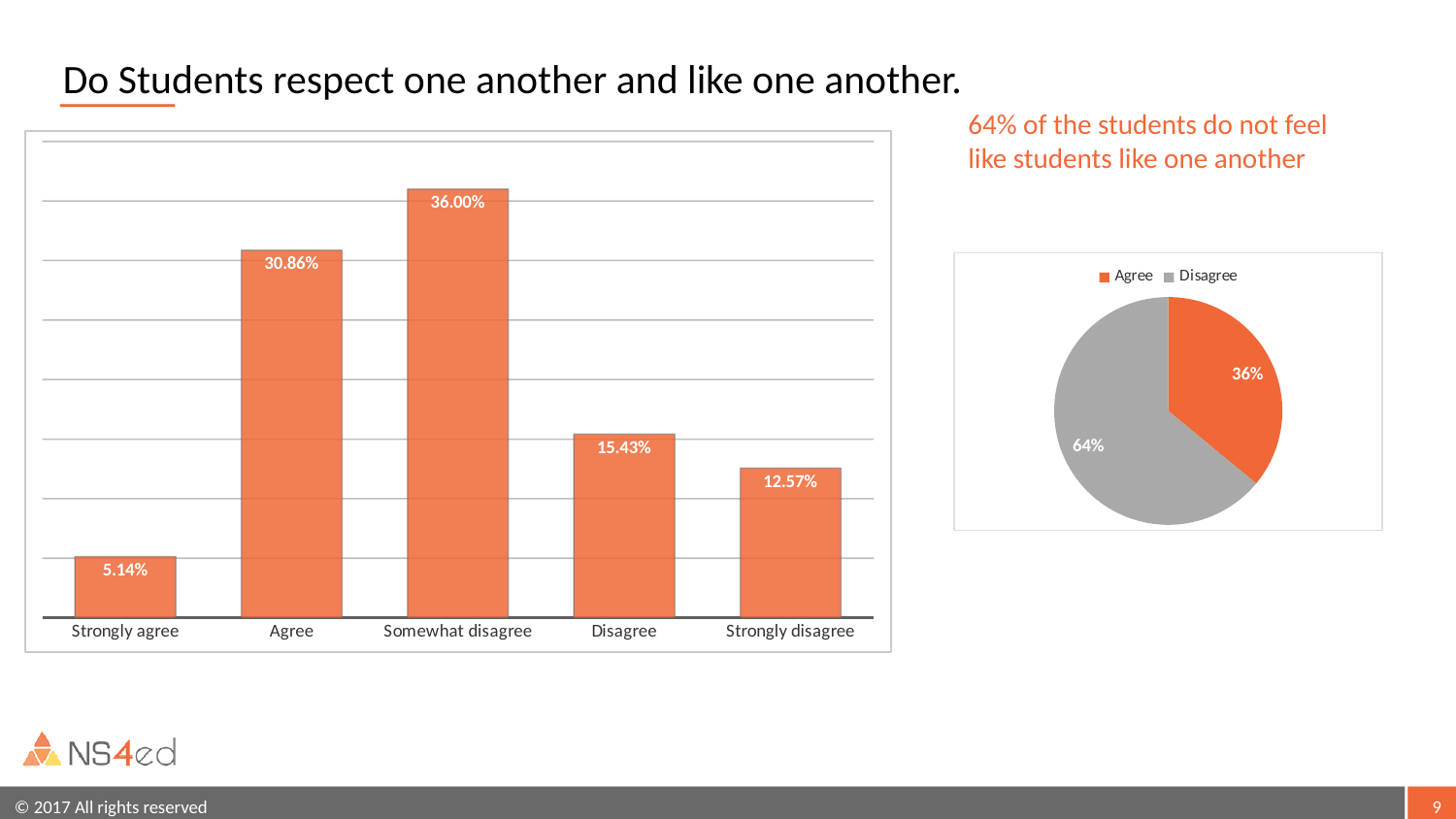
What kind of chart is the chart on the left of the slide? Bar chart In the bar chart on the left, what is the difference between the values for Somewhat disagree and Agree? 5.14% In the bar chart on the left, which is larger, the value for Disagree or the value for Strongly disagree? Disagree In the bar chart on the left, what is the value for Strongly disagree? 12.57% How many categories are shown in the bar chart on the left? 5 In the pie chart on the right, what is the value for Agree? 36% In the pie chart on the right, what share does the Disagree slice have? 64% In the bar chart on the left, what is the value for Agree? 30.86% In the pie chart on the right, what colour is the Agree slice? Orange In the bar chart on the left, which category has the lowest value? Strongly agree In the bar chart on the left, which category has the highest value? Somewhat disagree How many entries does the legend of the pie chart on the right list? 2